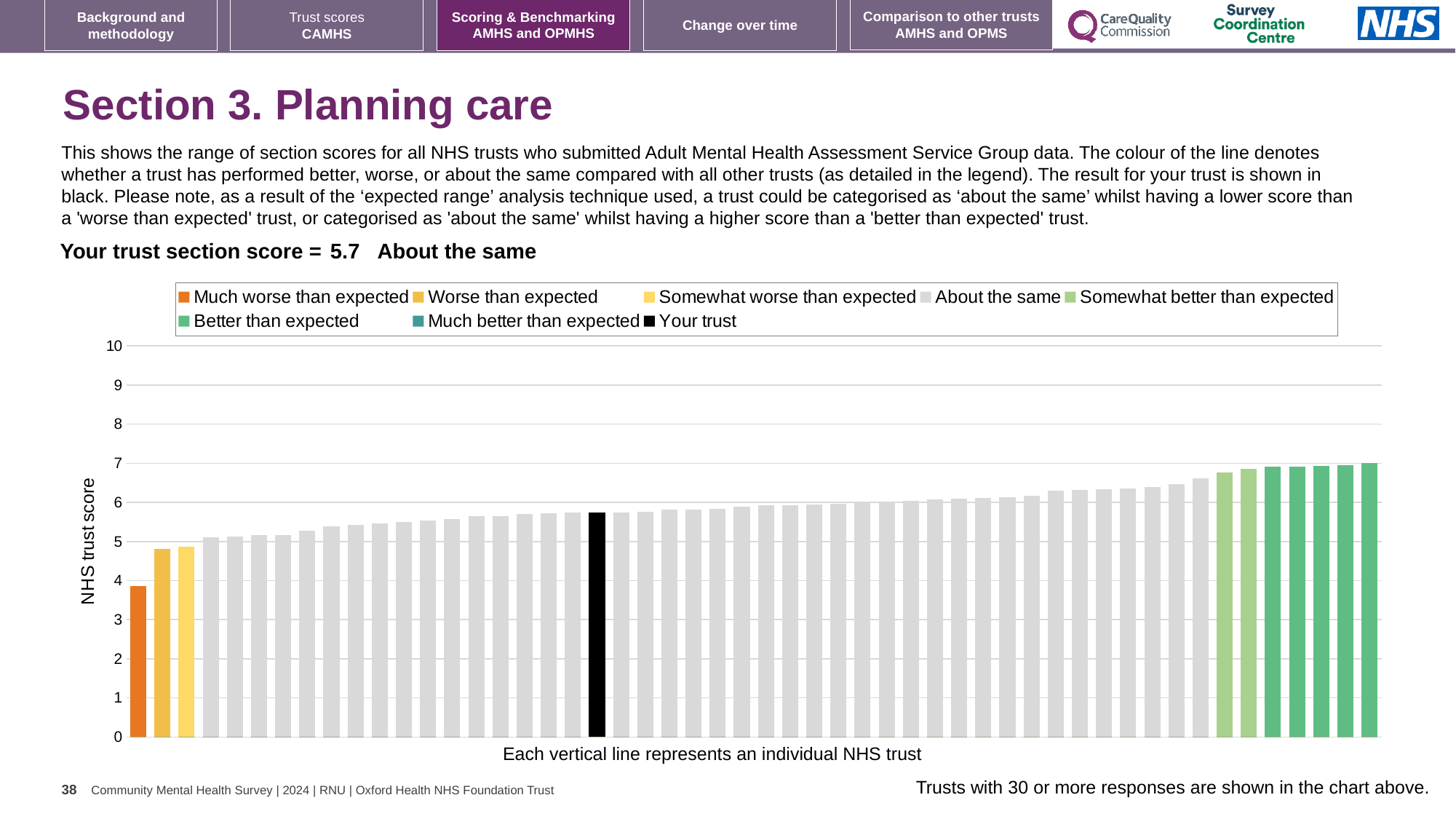
Which legend category does the tallest bar on the chart belong to? Better than expected What kind of chart is shown on the slide? Bar chart How many entries does the chart legend list? 8 Is the value of the lowest bar (the 'Much worse than expected' trust) greater or less than 4? less Do the bar heights rise or fall moving from left to right along the x axis? Rise What is the label on the vertical axis of the chart? NHS trust score Is the value of the tallest bar on the chart greater or less than 6? greater Which legend category does the lowest bar on the chart belong to? Much worse than expected What colour is the bar representing 'Your trust'? Black What is the section score for 'Your trust' shown on the slide? 5.7 Which performance category is 'Your trust' placed in for Planning care? About the same How many bars are coloured as 'Worse than expected' (yellow)? 1